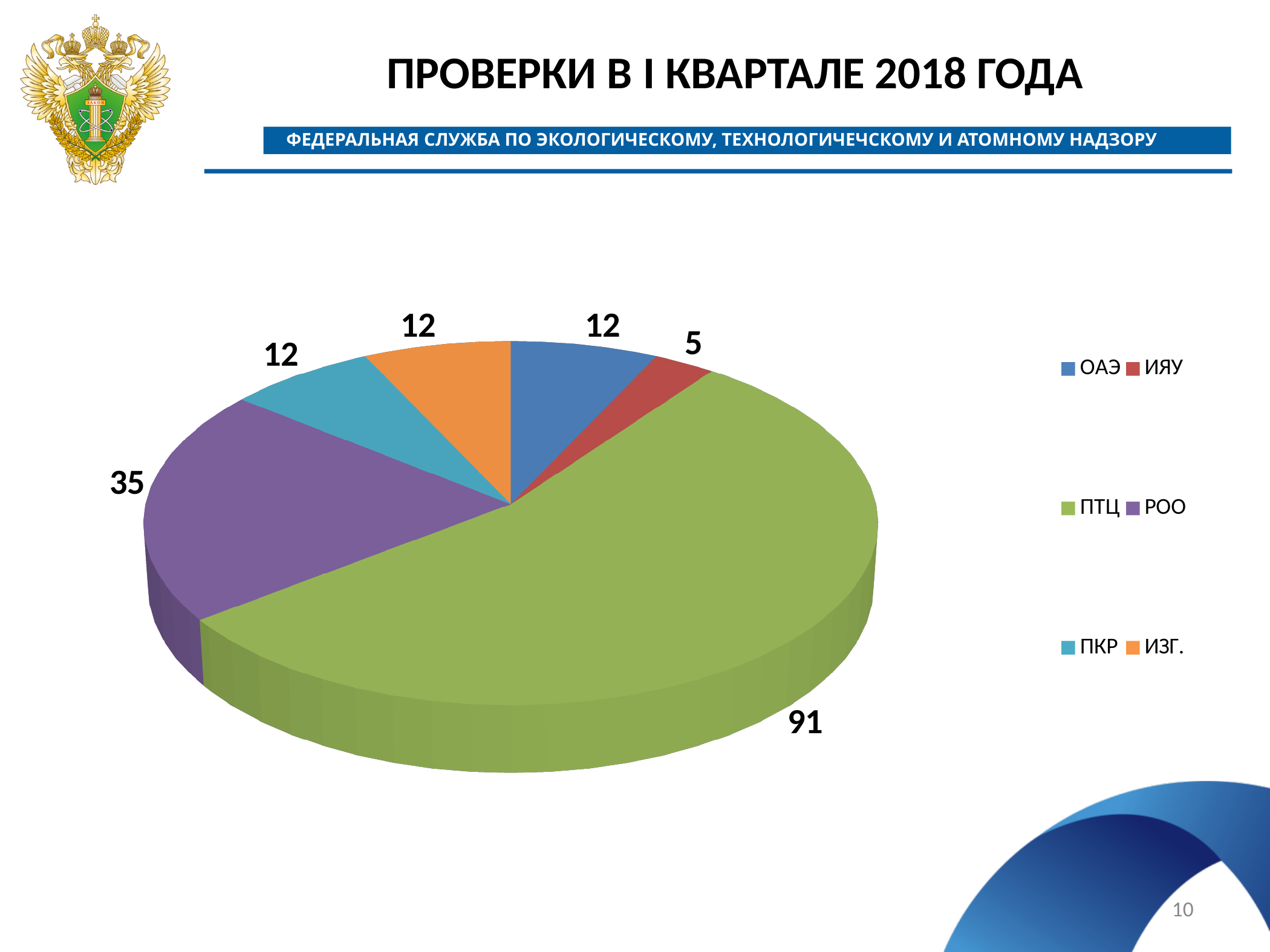
What is the value for РОО? 35 What is the value for ПТЦ? 91 How many slices does the pie chart have? 6 What is the value for ИЯУ? 5 What is the difference between the values for ПТЦ and РОО? 56 What is the total of all the values shown in the pie chart? 167 What kind of chart is shown on the slide? pie chart What colour is the ПТЦ slice in the pie chart? green Which category has the largest slice in the pie chart? ПТЦ Which category has the smallest slice in the pie chart? ИЯУ What is the value for ОАЭ? 12 Which is larger, the value for РОО or the value for ОАЭ? РОО